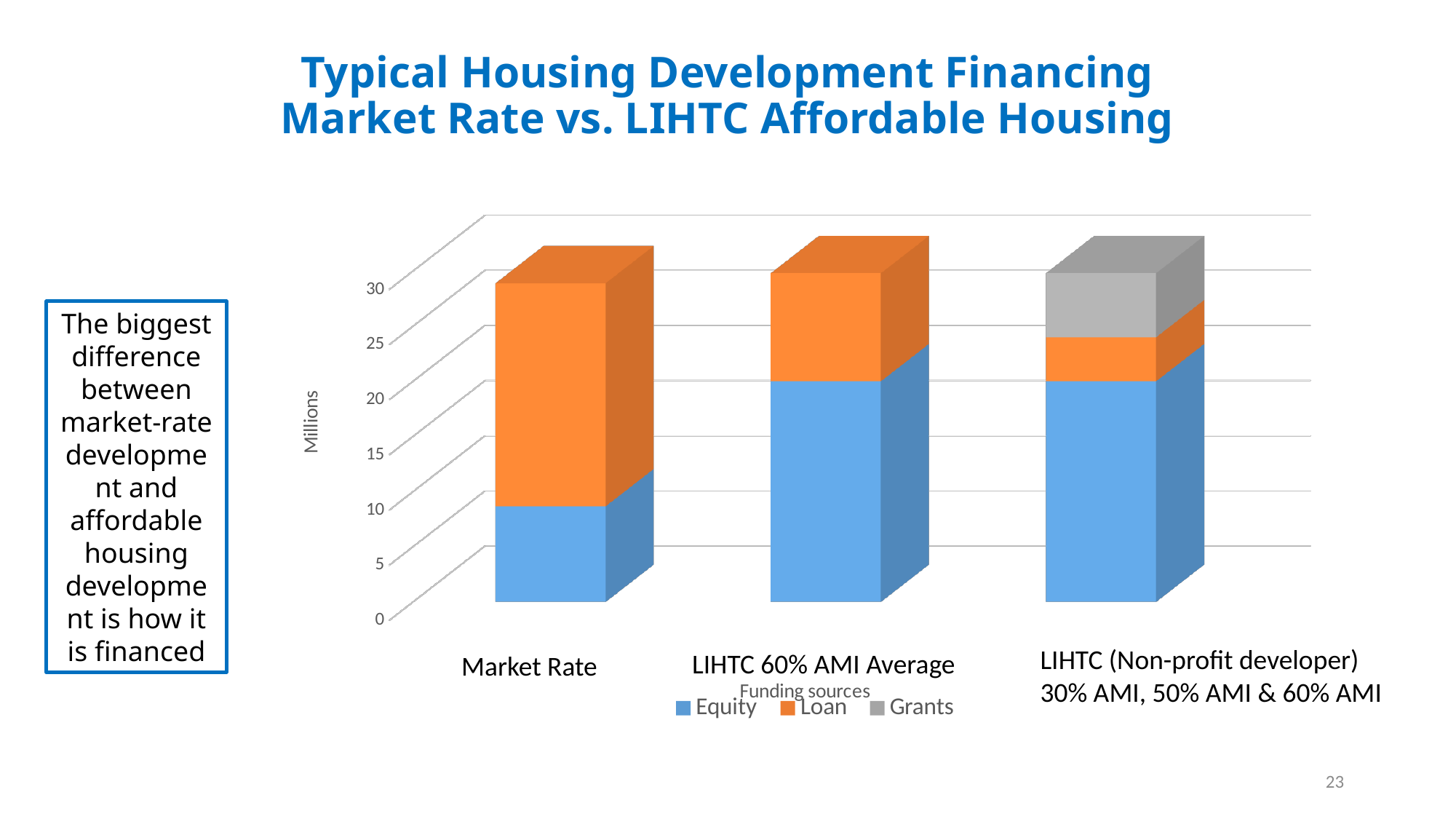
How many series does the chart's legend list? 3 Which has the larger Loan value: Market Rate or LIHTC 60% AMI Average? Market Rate What is the label on the vertical axis of the chart? Millions How many categories are shown along the x axis of the chart? 3 What kind of chart is shown on the slide? Stacked bar chart Is the Loan value for Market Rate greater or less than 15? greater Is the Equity value for Market Rate greater or less than 15? less Is the Loan value for LIHTC (Non-profit developer) greater or less than 10? less Which has the larger Equity value: Market Rate or LIHTC 60% AMI Average? LIHTC 60% AMI Average What are the series listed in the chart's legend? Equity, Loan, Grants Which category is the only one with a Grants segment? LIHTC (Non-profit developer) 30% AMI, 50% AMI & 60% AMI